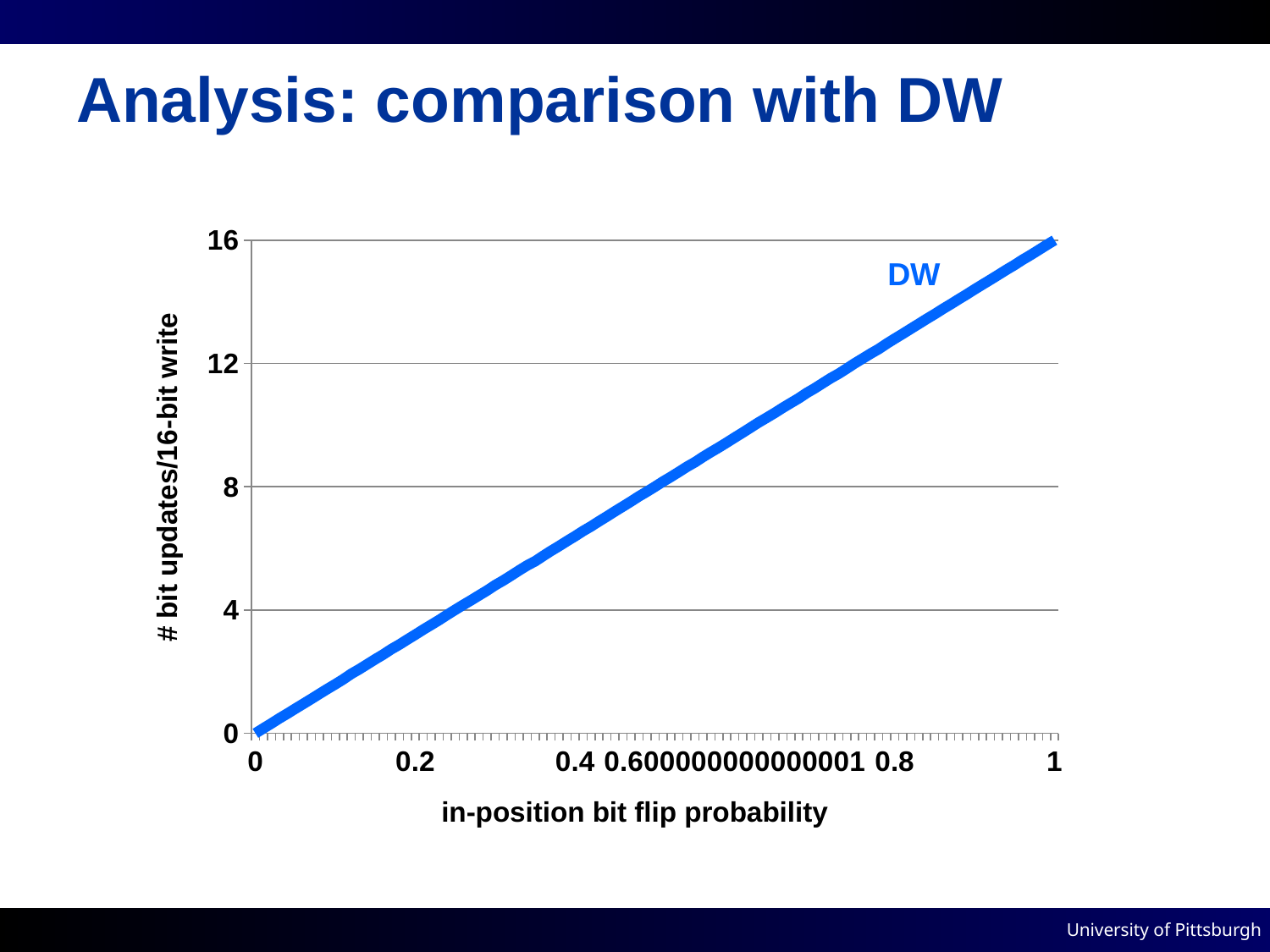
Is the value for DW at a bit flip probability of 0.4 greater or less than 8? less Is the value for DW at a bit flip probability of 0.2 greater or less than 4? less What is the name of the series plotted on the chart? DW At which in-position bit flip probability does the DW line reach its highest value? 1 What is the title of the x axis? in-position bit flip probability At which in-position bit flip probability does the DW line have its lowest value? 0 Does the DW line rise or fall as the in-position bit flip probability increases? rise Is the DW value at a bit flip probability of 0.8 larger or smaller than the DW value at 0.4? larger Is the value for DW at a bit flip probability of 0.8 greater or less than 12? greater What is the value of DW (# bit updates/16-bit write) when the in-position bit flip probability is 1? 16 What is the value of DW when the in-position bit flip probability is 0? 0 What kind of chart is shown on the slide? line chart